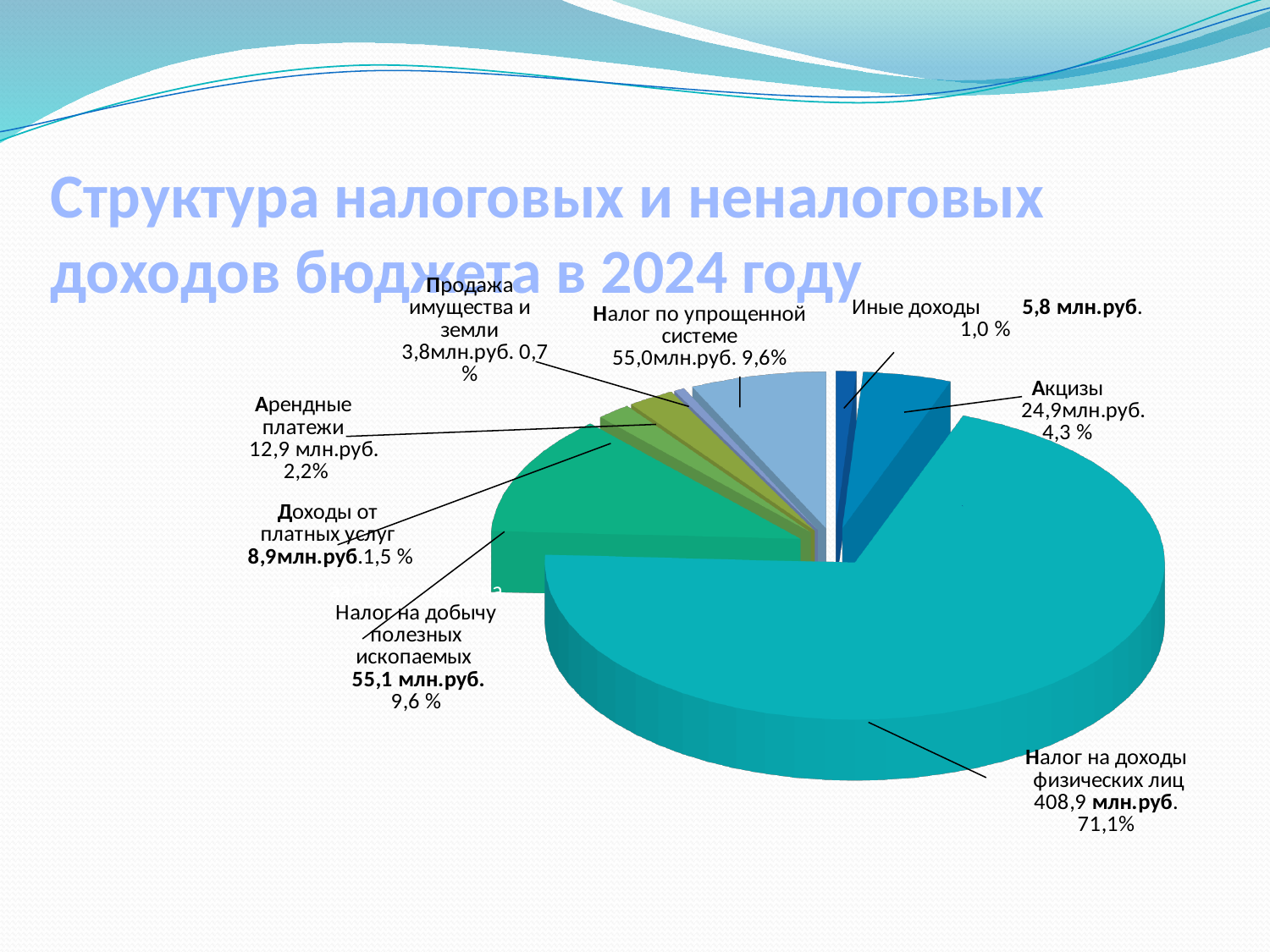
What is the value for Акцизы? 24,9 млн.руб. What is the difference in value between Налог на доходы физических лиц and Акцизы? 384,0 млн.руб. Which category has the smallest slice of the pie? Продажа имущества и земли Which category has the largest slice of the pie? Налог на доходы физических лиц How many categories (slices) does the pie chart have? 8 What is the value for Налог на доходы физических лиц? 408,9 млн.руб. What is the value for Иные доходы? 5,8 млн.руб. Which is larger, Акцизы or Арендные платежи? Акцизы What type of chart is shown on the slide? Pie chart What share of the pie does Налог по упрощенной системе represent? 9,6% What share of the pie does Налог на доходы физических лиц represent? 71,1% What is the title of the chart on the slide? Структура налоговых и неналоговых доходов бюджета в 2024 году